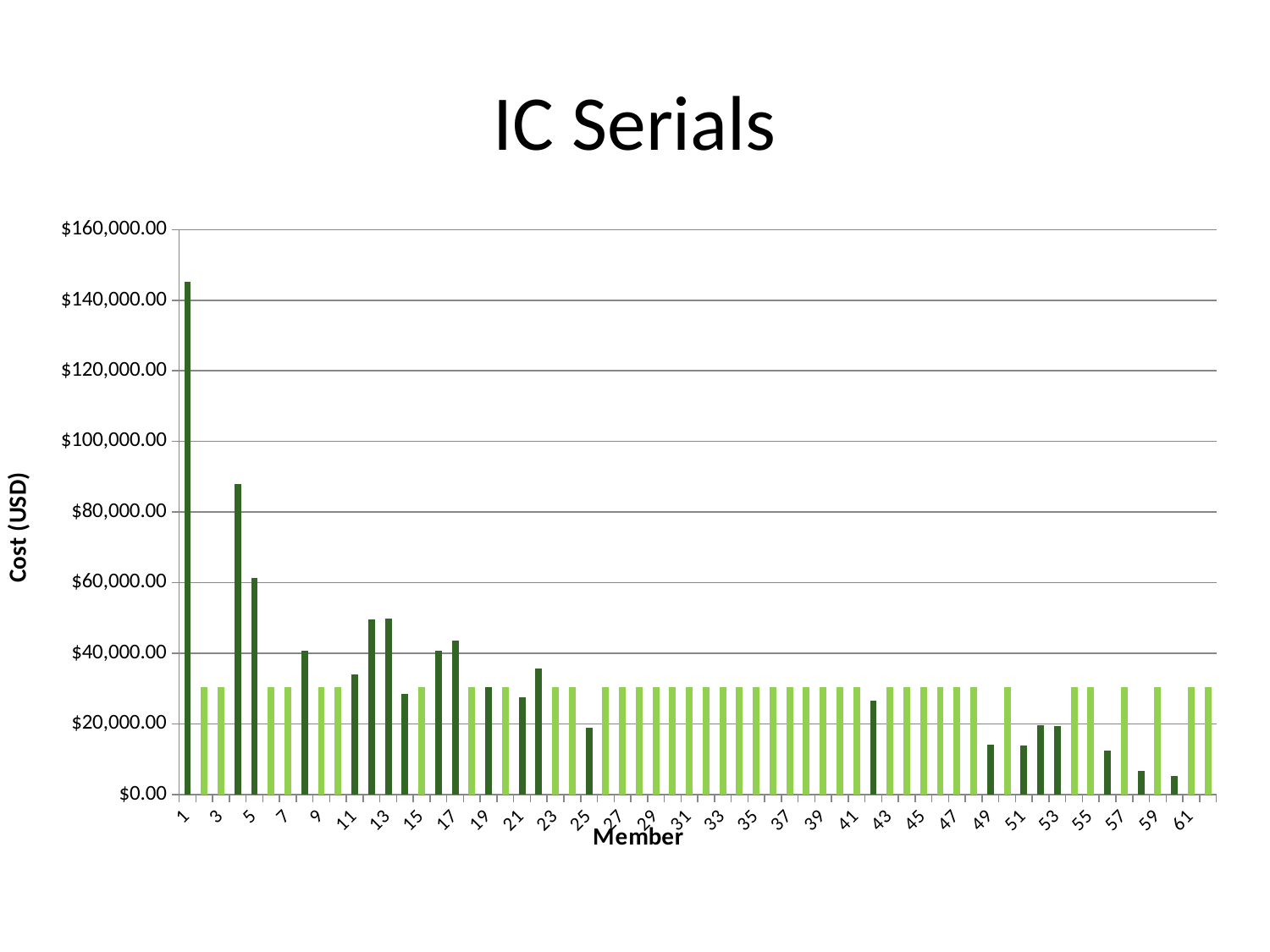
Is the value for member 60 greater or less than $20,000.00? less Is the value for member 12 greater or less than $40,000.00? greater Is the value for member 1 greater or less than $140,000.00? greater Which member has the highest cost? 1 Which is larger, the value for member 1 or the value for member 4? member 1 What is the title of the chart? IC Serials Which is larger, the value for member 4 or the value for member 5? member 4 What kind of chart is shown on the slide? bar chart What is the label on the vertical axis? Cost (USD)